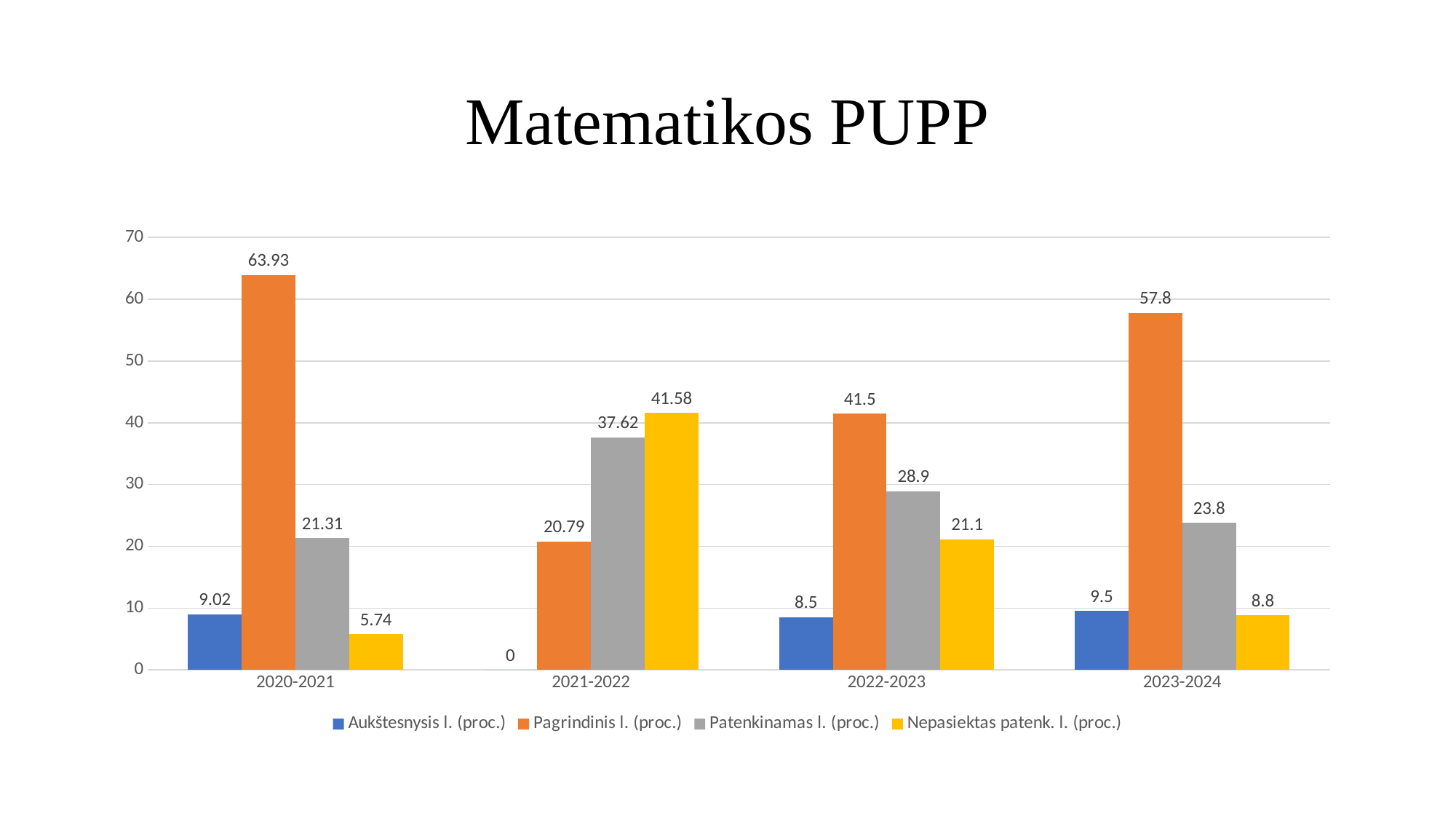
What is the value for Nepasiektas patenk. l. (proc.) in 2021-2022? 41.58 In which year is the value for Pagrindinis l. (proc.) highest? 2020-2021 What is the difference between the Pagrindinis l. (proc.) values for 2020-2021 and 2023-2024? 6.13 How many year categories are shown on the x axis? 4 In which year is the value for Aukštesnysis l. (proc.) lowest? 2021-2022 What is the value for Pagrindinis l. (proc.) in 2020-2021? 63.93 What is the value for Aukštesnysis l. (proc.) in 2023-2024? 9.5 What is the title of the chart? Matematikos PUPP How many series does the legend list? 4 What is the value for Patenkinamas l. (proc.) in 2022-2023? 28.9 What kind of chart is shown on the slide? Bar chart Which is larger in 2021-2022: Patenkinamas l. (proc.) or Nepasiektas patenk. l. (proc.)? Nepasiektas patenk. l. (proc.)